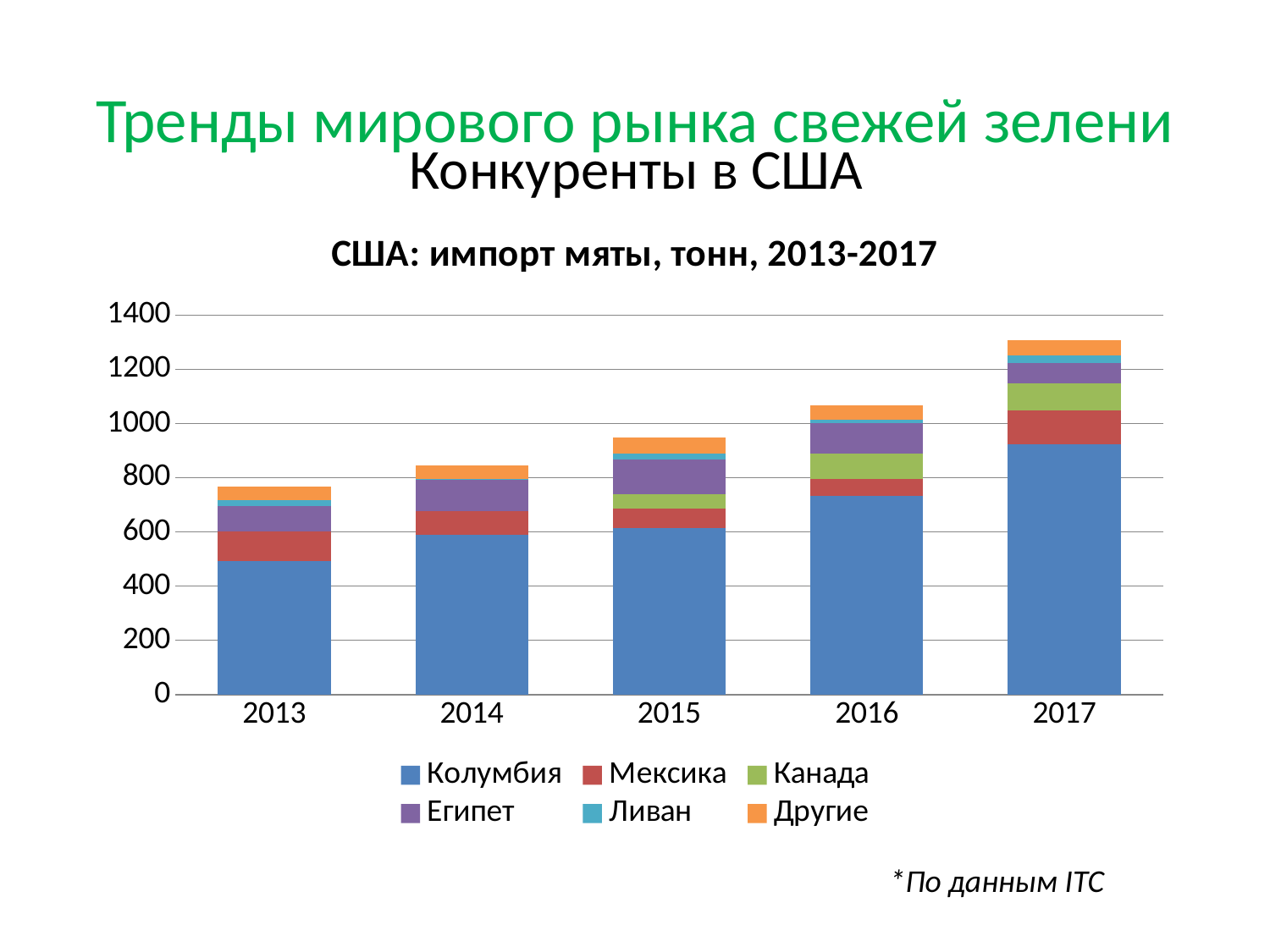
What kind of chart is shown on the slide? Stacked bar chart How many series does the legend list? 6 Is the Колумбия segment for 2017 greater or less than 800? greater Which year has the highest total mint import? 2017 Which year has the larger total import, 2015 or 2016? 2016 Is the Колумбия segment for 2013 greater or less than 600? less Which year has the lowest total mint import? 2013 What is the title of the chart? США: импорт мяты, тонн, 2013-2017 Do the total imports rise or fall from 2013 to 2017? Rise How many years are shown on the x axis of the chart? 5 Is the total value for 2013 greater or less than 800? less